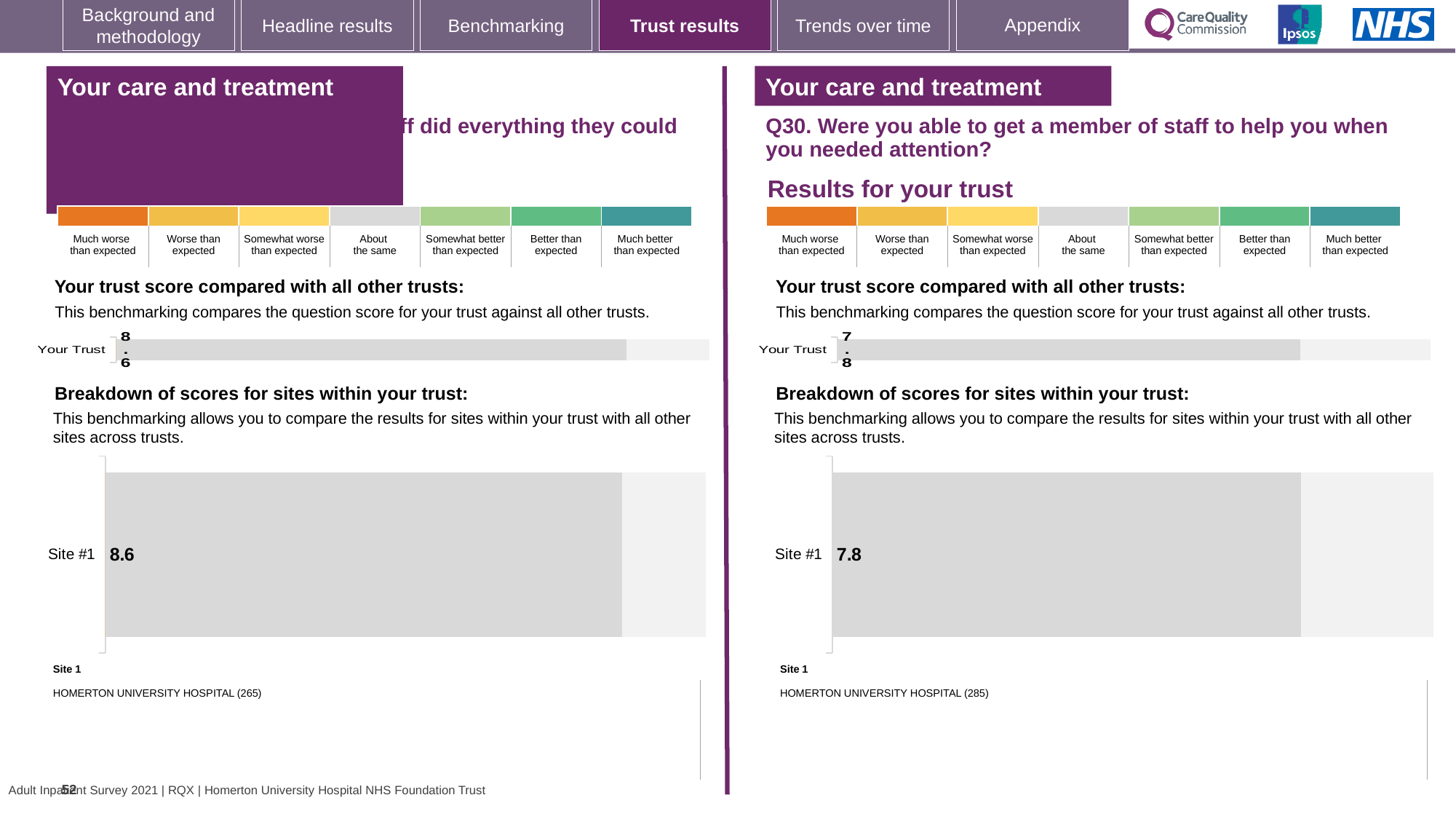
Is the Site #1 score in the right panel (Q30) greater or less than the Site #1 score in the left panel? less In the left panel's 'Breakdown of scores for sites within your trust' chart, what is the score for Site #1? 8.6 What kind of chart is used for the 'Breakdown of scores for sites within your trust' in the right panel (Q30)? Bar chart In the left panel, which hospital is listed as Site 1 below the breakdown chart? HOMERTON UNIVERSITY HOSPITAL (265) In the left panel's 'Your trust score compared with all other trusts' chart, what is the value for Your Trust? 8.6 How many sites are plotted in the right panel (Q30) 'Breakdown of scores for sites within your trust' chart? 1 In the right panel (Q30), which hospital is listed as Site 1 below the breakdown chart? HOMERTON UNIVERSITY HOSPITAL (285) How many sites are plotted in the left panel's 'Breakdown of scores for sites within your trust' chart? 1 Which is larger: the Your Trust score in the left panel or the Your Trust score in the right panel (Q30)? Left panel What is the difference between the Site #1 score in the left panel and the Site #1 score in the right panel (Q30)? 0.8 In the right panel (Q30) 'Your trust score compared with all other trusts' chart, what is the value for Your Trust? 7.8 In the right panel (Q30) 'Breakdown of scores for sites within your trust' chart, what is the score for Site #1? 7.8